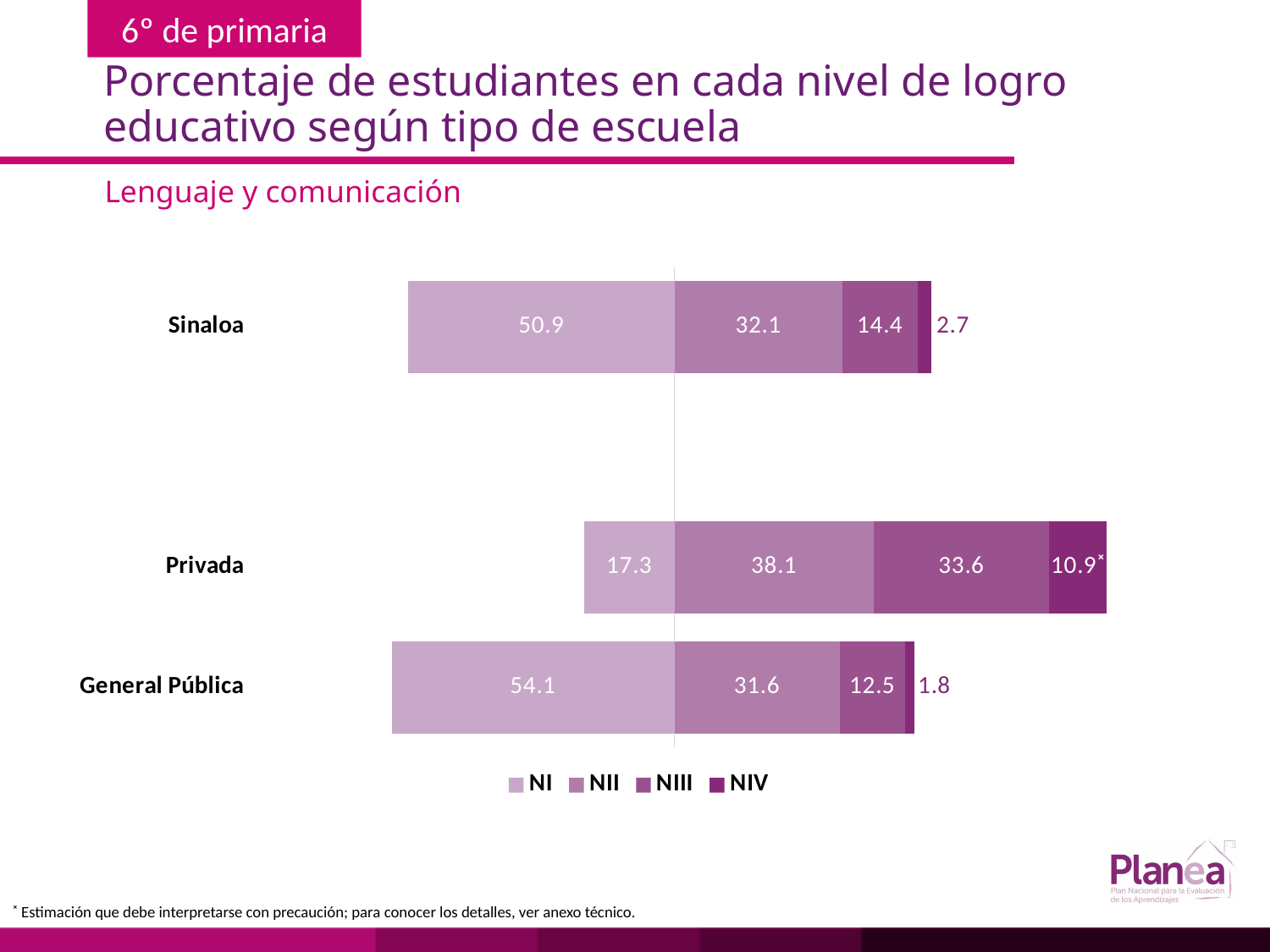
What is the NII value for General Pública? 31.6 What is the NIV value for General Pública? 1.8 What is the NIII value for Privada? 33.6 What is the total of the stacked bar for General Pública? 100.0 Which category has the highest NI value? General Pública Which category has the lowest NIV value? General Pública What is the difference between the NI values for General Pública and Privada? 36.8 What kind of chart is shown on the slide? Stacked bar chart How many categories are shown on the chart? 3 Which is larger, the NII value for Privada or the NII value for Sinaloa? Privada How many series does the legend list? 4 What is the NI value for Sinaloa? 50.9